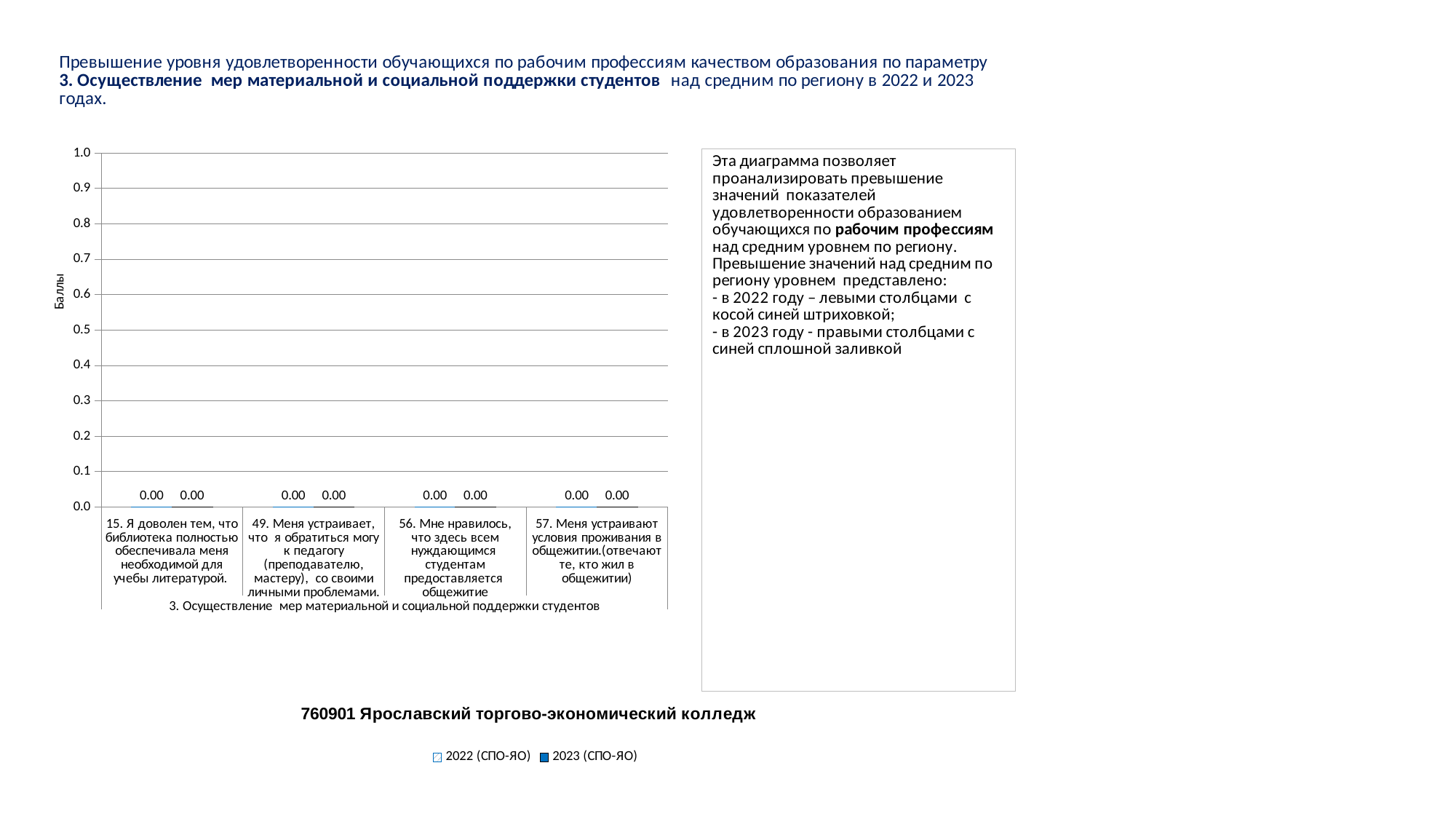
What is the highest value shown on the vertical axis of the chart? 1.0 Is the value for 2023 (СПО-ЯО) for category 49 greater or less than 0.5? less What kind of chart is shown on the slide? bar chart What is the value for 2022 (СПО-ЯО) for category 15 (Я доволен тем, что библиотека полностью обеспечивала меня необходимой для учебы литературой)? 0.00 What is the difference between the 2022 (СПО-ЯО) and 2023 (СПО-ЯО) values for category 15? 0.00 What is the value for 2023 (СПО-ЯО) for category 56 (Мне нравилось, что здесь всем нуждающимся студентам предоставляется общежитие)? 0.00 How many categories are shown on the x axis of the chart? 4 What is the label of the vertical axis of the chart? Баллы How many series does the legend list? 2 What is the value for 2023 (СПО-ЯО) for category 57 (Меня устраивают условия проживания в общежитии)? 0.00 What is the value for 2022 (СПО-ЯО) for category 49 (Меня устраивает, что я обратиться могу к педагогу со своими личными проблемами)? 0.00